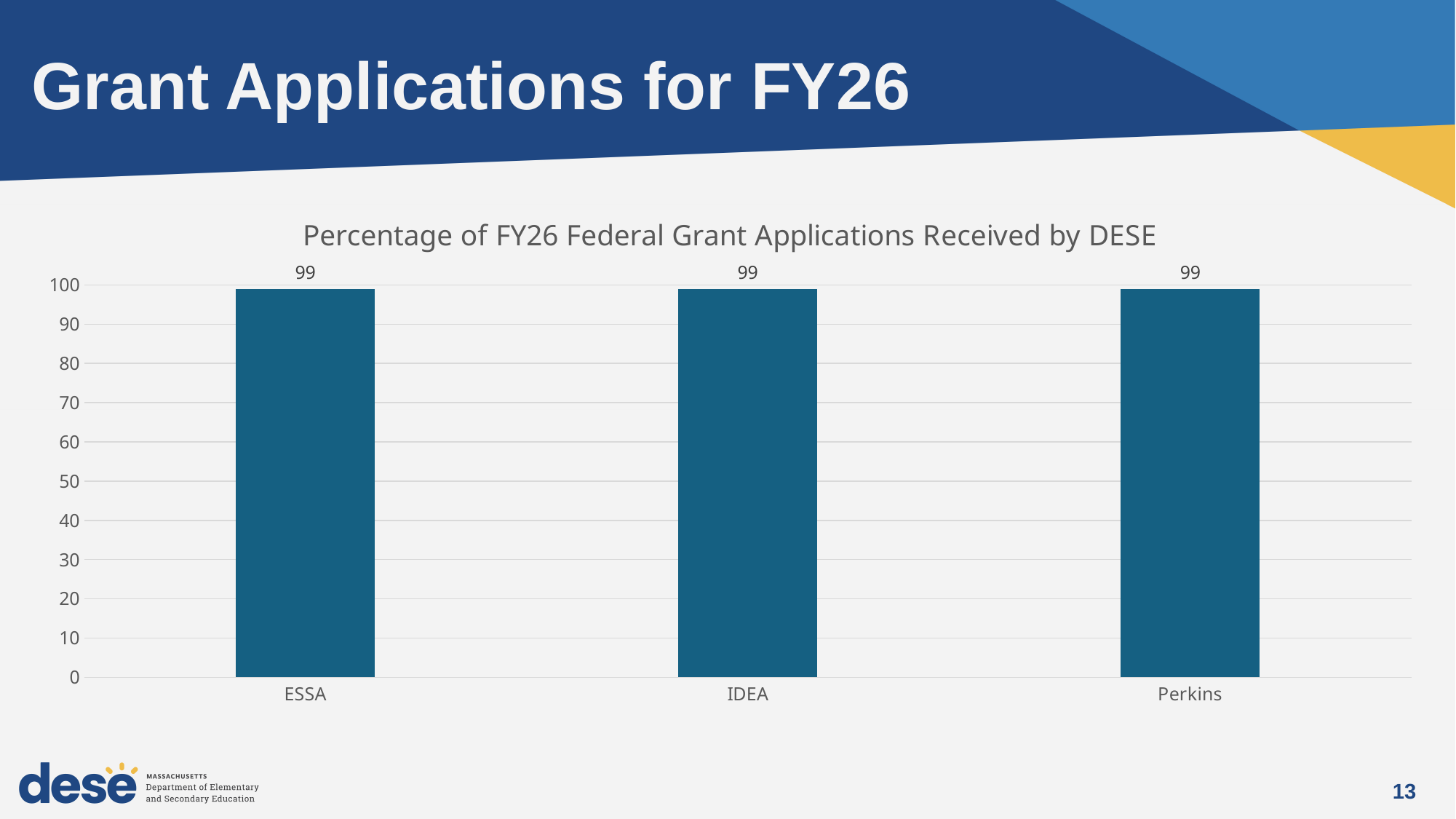
What is the value for IDEA? 99 What is the title of the chart? Percentage of FY26 Federal Grant Applications Received by DESE Is the value for IDEA greater or less than 90? greater What is the value for Perkins? 99 What kind of chart is shown on the slide? bar chart What is the difference between the values for ESSA and Perkins? 0 What is the highest value shown on the y axis? 100 How many categories are shown on the x axis? 3 Do the values rise, fall, or stay the same from ESSA to Perkins? stay the same Is the value for Perkins greater or less than 50? greater What is the value for ESSA? 99